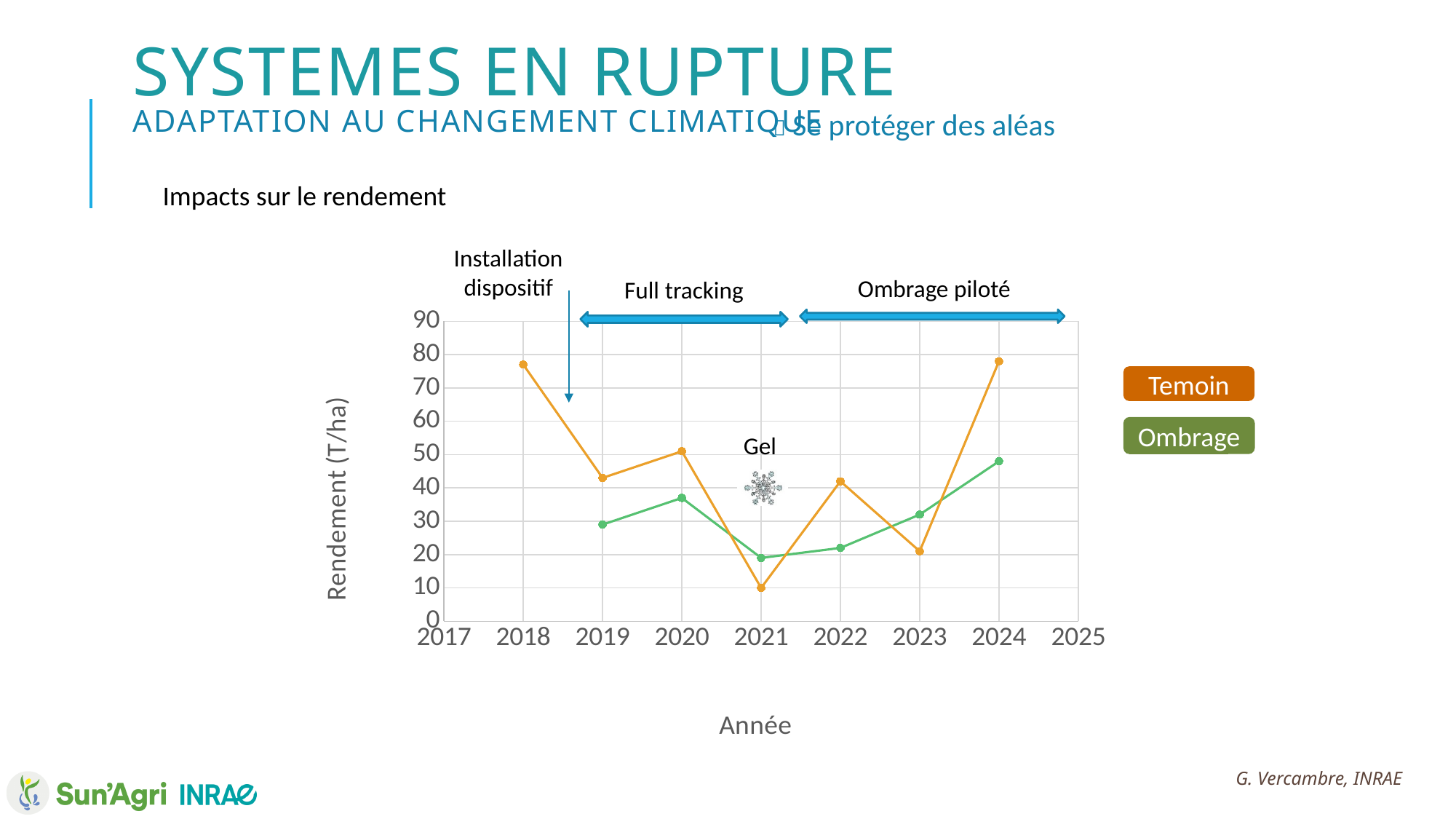
What is the label of the y axis? Rendement (T/ha) In 2023, which series has the larger value, Temoin or Ombrage? Ombrage Which series is drawn in orange? Temoin How many series does the legend list? 2 In 2019, which series has the larger value, Temoin or Ombrage? Temoin Is the Temoin value for 2018 greater or less than 70? greater Is the Ombrage value for 2020 greater or less than 30? greater Is the Ombrage value for 2024 greater or less than 50? less In which year is the Ombrage series at its highest? 2024 How many data points does the Ombrage series have? 6 In which year is the Temoin series at its lowest? 2021 What kind of chart is shown on the slide? line chart